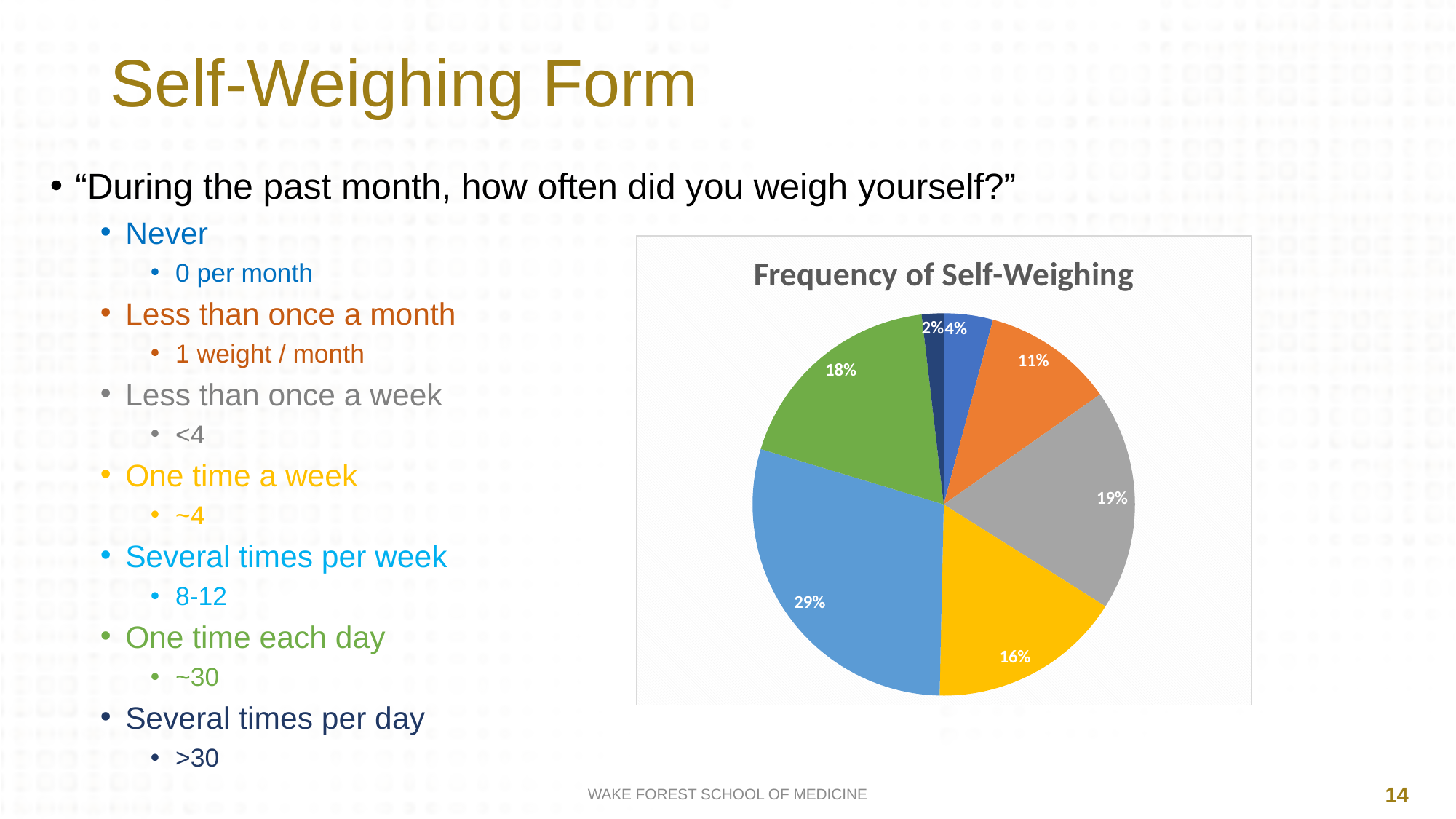
How many slices does the pie chart have? 7 What percentage is shown on the yellow slice of the pie chart? 16% Which slice is larger, the gray slice or the yellow slice? the gray slice What percentage is shown on the largest slice of the pie chart? 29% What percentage is shown on the orange slice of the pie chart? 11% What percentage is shown on the smallest slice of the pie chart? 2% What percentage is shown on the green slice of the pie chart? 18% What percentage is shown on the gray slice of the pie chart? 19% What kind of chart is shown on the slide? pie chart Does the pie chart include a legend? No What is the difference in percentage points between the light blue slice (29%) and the green slice (18%)? 11 What is the title of the chart? Frequency of Self-Weighing